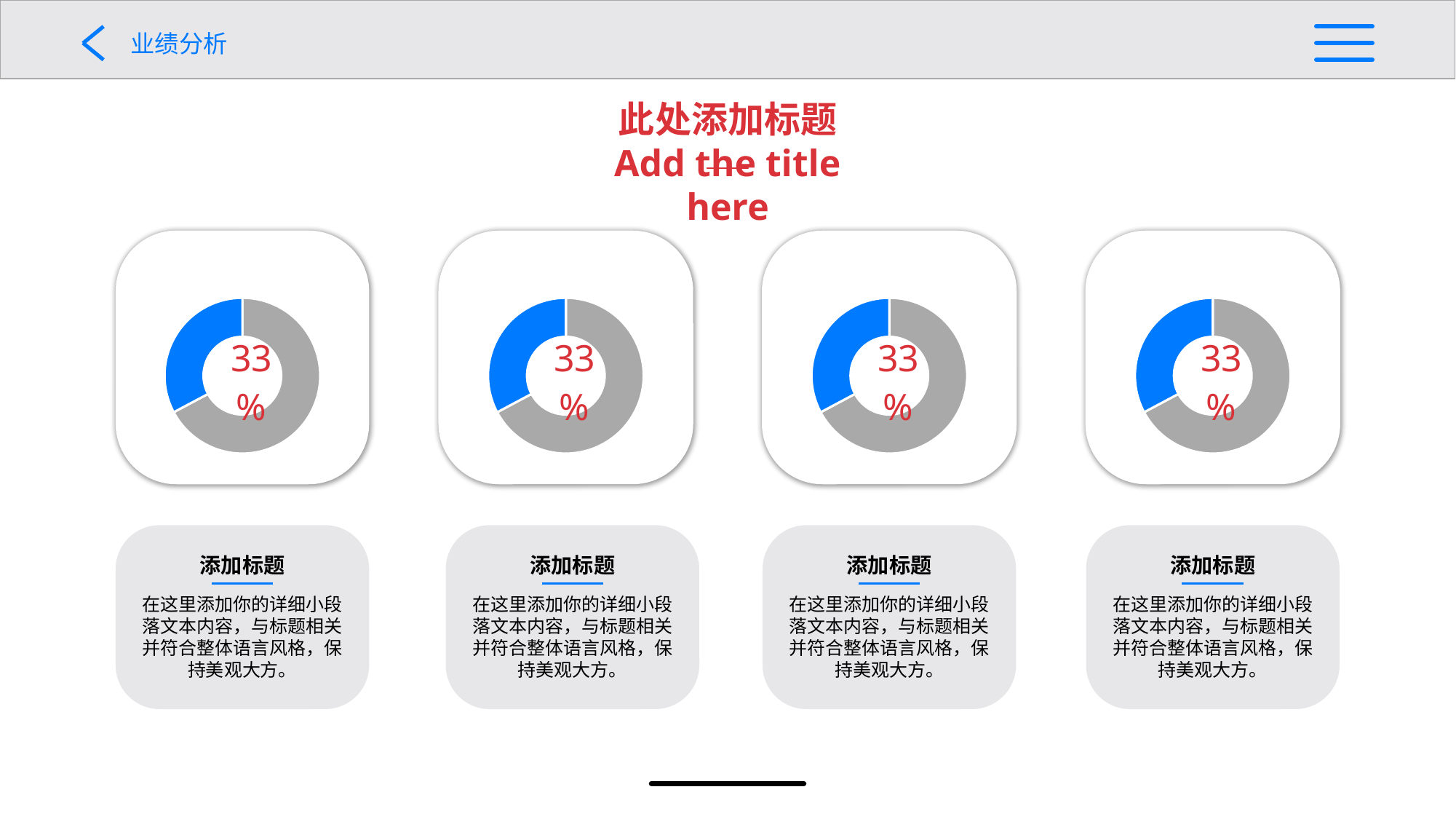
How many slices does each doughnut chart have? 2 In the leftmost doughnut chart, which slice is larger, the blue one or the grey one? grey What percentage is printed in the centre of the second doughnut chart from the left? 33% What percentage is printed in the centre of the third doughnut chart from the left? 33% In the rightmost doughnut chart, is the blue slice greater or less than 50% of the ring? less What percentage is printed in the centre of the leftmost doughnut chart? 33% How many doughnut charts are on the slide? 4 What kind of chart is shown in the leftmost rounded box? doughnut chart What colour is the text label in the centre of each doughnut chart? red Do the four doughnut charts show the same percentage or different percentages? the same What percentage is printed in the centre of the rightmost doughnut chart? 33% What colour is the smaller slice in the third doughnut chart from the left? blue